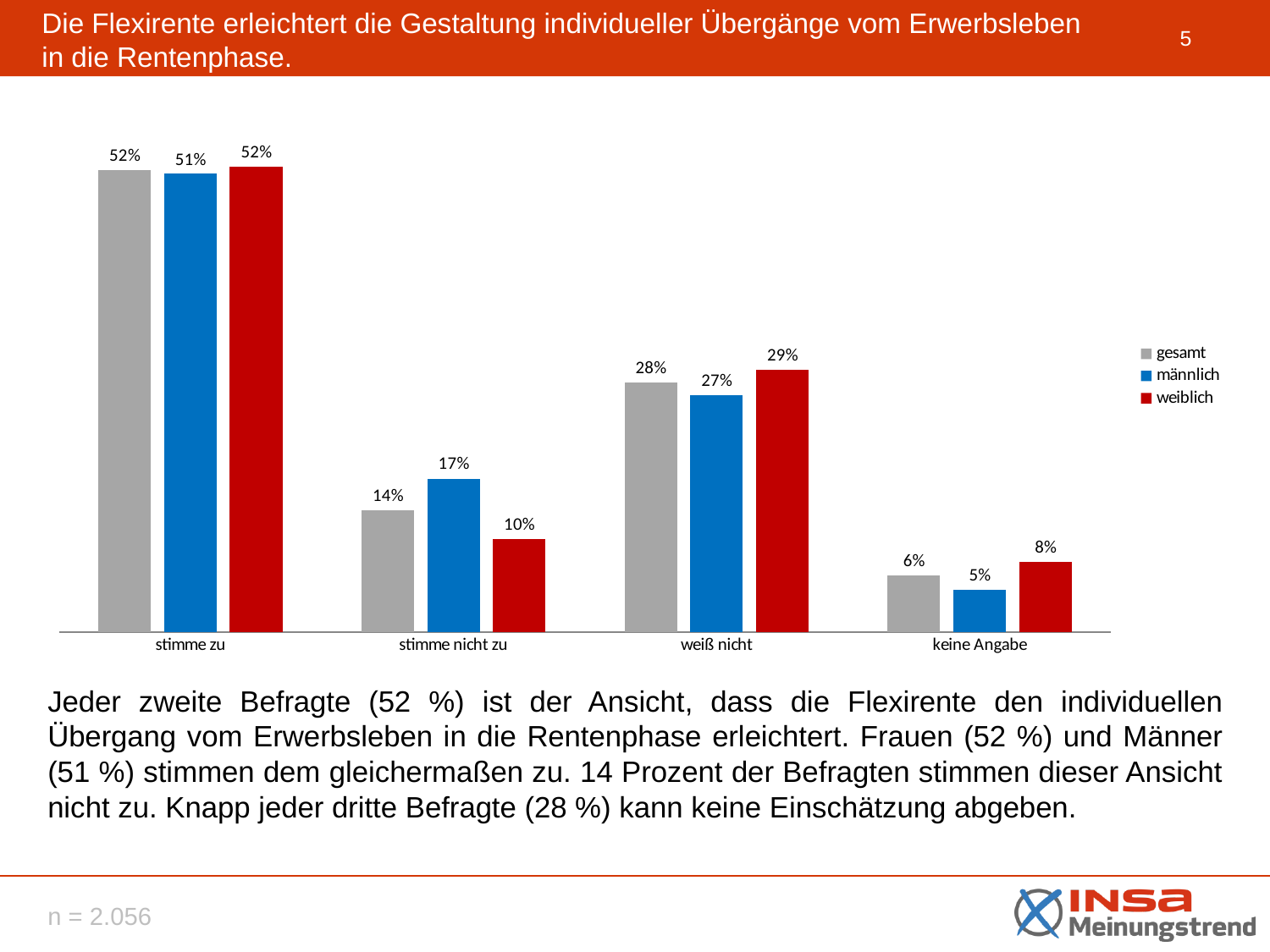
What is the value for "männlich" in the "stimme nicht zu" category? 17% What is the value for "männlich" in the "keine Angabe" category? 5% How many categories are shown on the x axis? 4 In the "keine Angabe" category, which is larger: the value for "gesamt" or for "weiblich"? weiblich What is the value for "weiblich" in the "weiß nicht" category? 29% How many series does the legend list? 3 Which category has the highest value for the "gesamt" series? stimme zu Which colour represents the "männlich" series in the legend? blue Which category has the lowest value for the "weiblich" series? keine Angabe What is the difference between the "männlich" and "weiblich" values in the "stimme nicht zu" category? 7% What is the value for "gesamt" in the "stimme zu" category? 52% What kind of chart is shown on the slide? bar chart